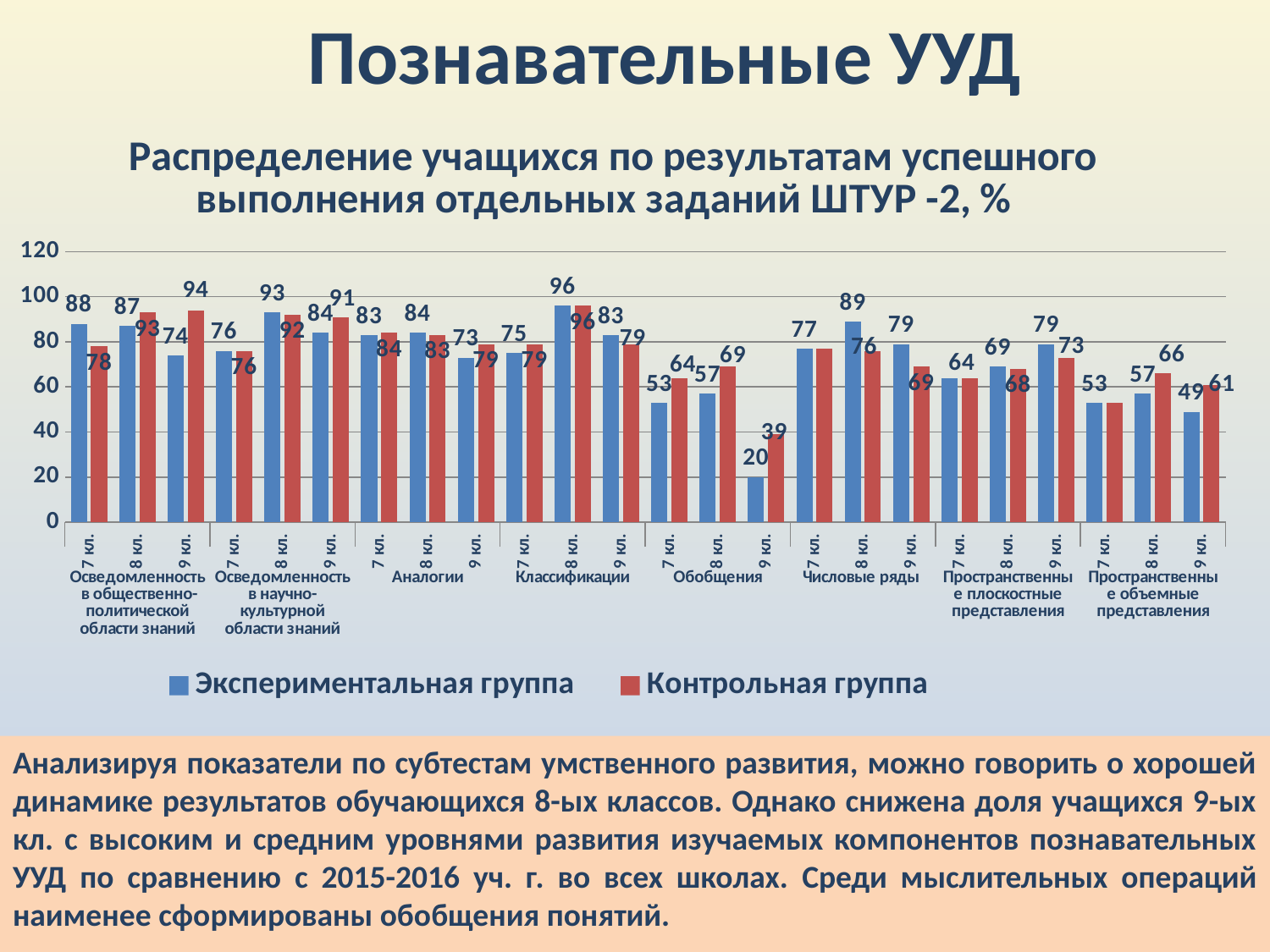
Which group has the larger value in Числовые ряды, 8 кл.: Экспериментальная группа or Контрольная группа? Экспериментальная группа In which category does the Экспериментальная группа reach its highest value? Классификации, 8 кл. What is the difference between the Контрольная группа and the Экспериментальная группа in Обобщения, 9 кл.? 19 In which category does the Экспериментальная группа have its lowest value? Обобщения, 9 кл. What is the value for the Экспериментальная группа in Обобщения, 9 кл.? 20 What is the value for the Экспериментальная группа in Числовые ряды, 8 кл.? 89 What kind of chart is shown on the slide? Bar chart What is the value for the Контрольная группа in Пространственные объемные представления, 9 кл.? 61 How many series does the legend list? 2 What is the value for the Контрольная группа in Осведомленность в общественно-политической области знаний, 9 кл.? 94 How many subtest groups are shown along the x axis? 8 Which colour represents the Контрольная группа in the chart? Red